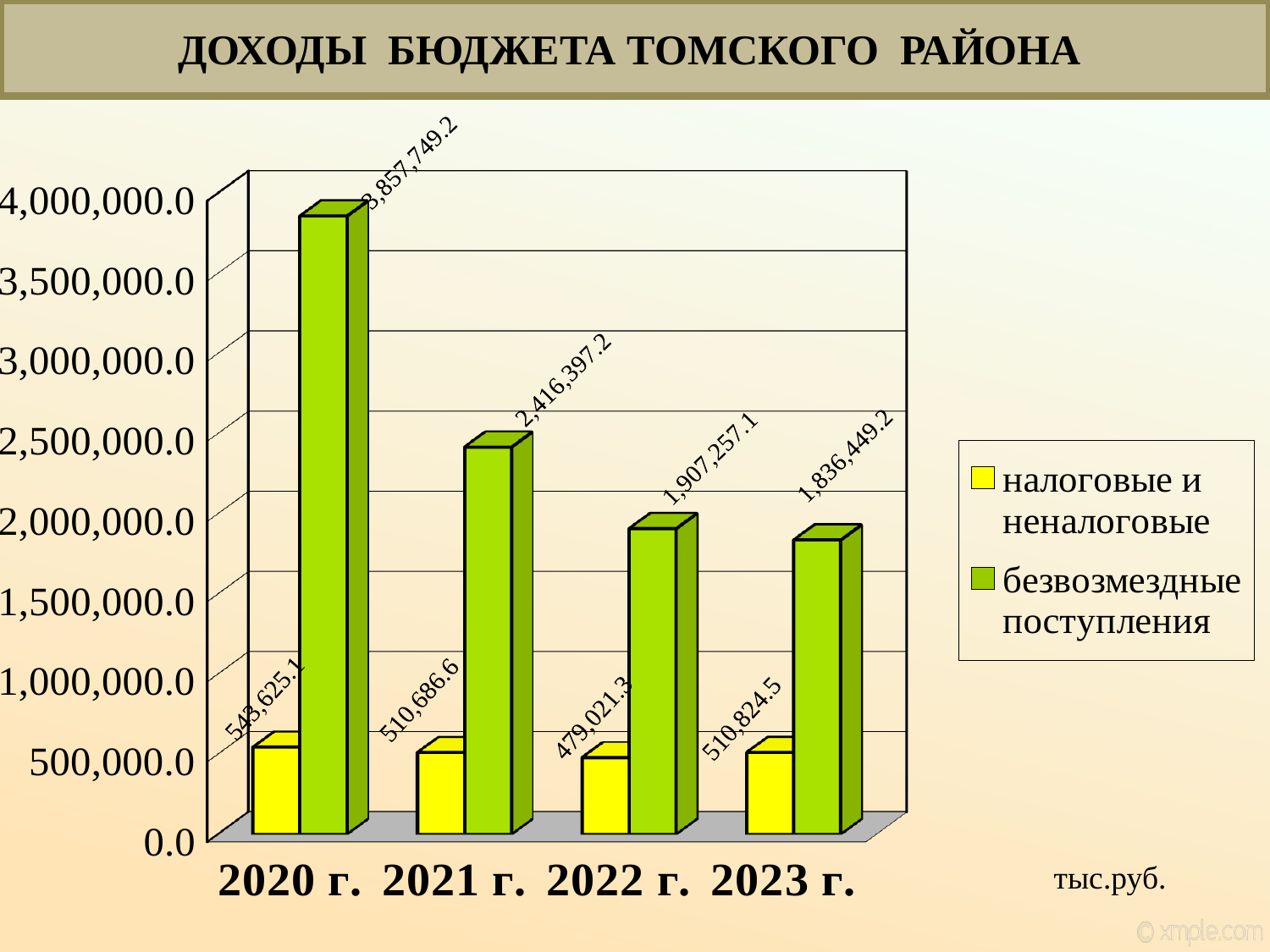
In which year is налоговые и неналоговые the lowest? 2022 г. What is the value of безвозмездные поступления for 2020 г.? 3,857,749.2 What is the value of налоговые и неналоговые for 2022 г.? 479,021.3 Which is larger: налоговые и неналоговые in 2020 г. or in 2022 г.? 2020 г. What kind of chart is shown on the slide? bar chart What is the difference between безвозмездные поступления in 2020 г. and 2021 г.? 1,441,352.0 Is the value of безвозмездные поступления for 2021 г. greater or less than 2,000,000.0? greater In which year is безвозмездные поступления the highest? 2020 г. How many years are shown on the x axis? 4 Do the values of безвозмездные поступления rise or fall from 2020 г. to 2023 г.? fall How many series does the legend list? 2 What is the value of безвозмездные поступления for 2021 г.? 2,416,397.2